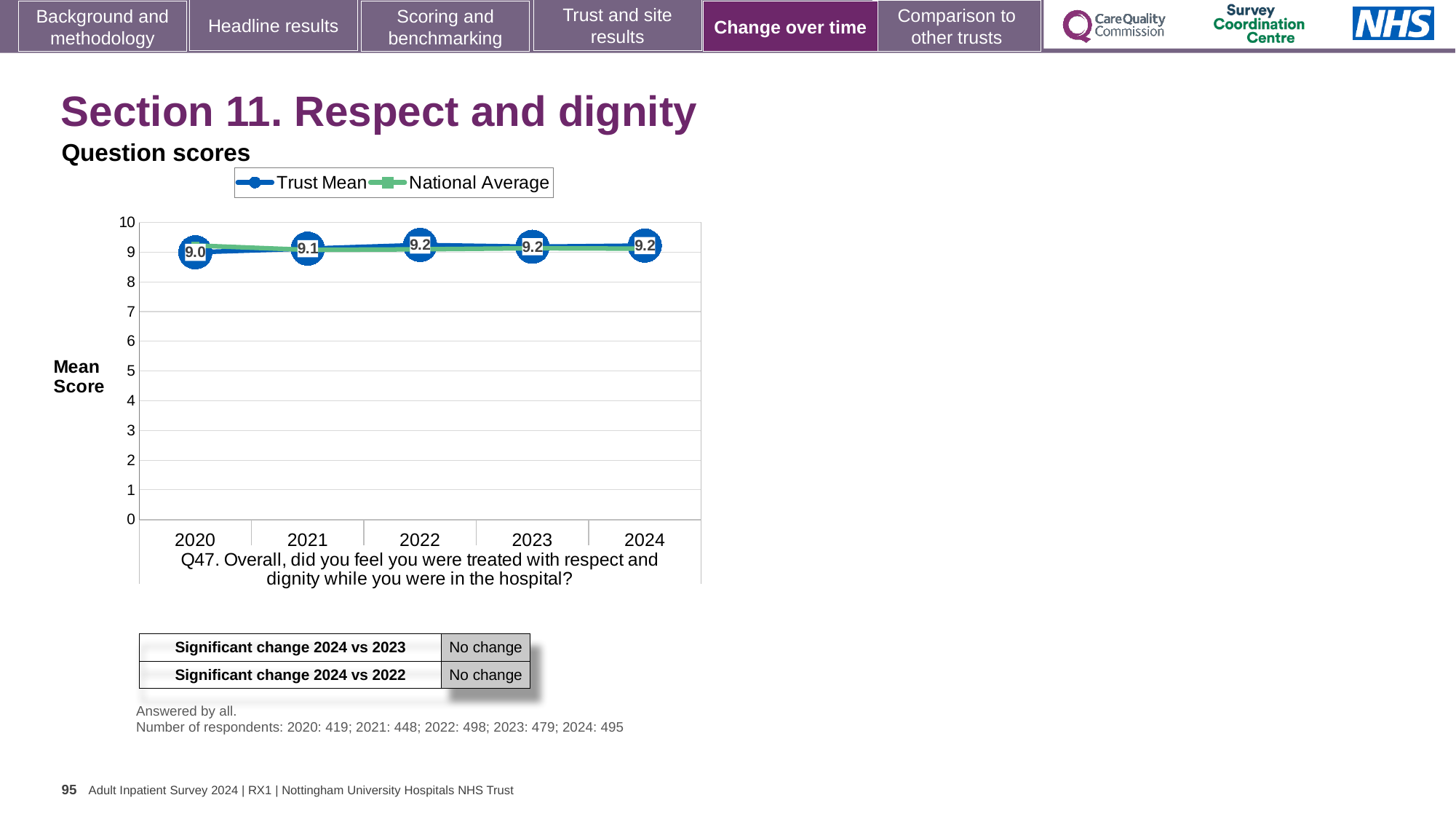
In which year is the Trust Mean lowest? 2020 Which is larger, the Trust Mean for 2021 or for 2020? 2021 What is the Trust Mean value for 2021? 9.1 What is the difference between the Trust Mean in 2024 and in 2020? 0.2 What kind of chart is shown on the slide? Line chart What is the label on the y axis of the chart? Mean Score How many years are plotted on the x axis? 5 Does the Trust Mean rise or fall from 2020 to 2024? Rise Is the National Average value for 2022 greater or less than 8? greater What is the Trust Mean value for 2024? 9.2 How many series does the legend list? 2 What is the Trust Mean value for 2020? 9.0